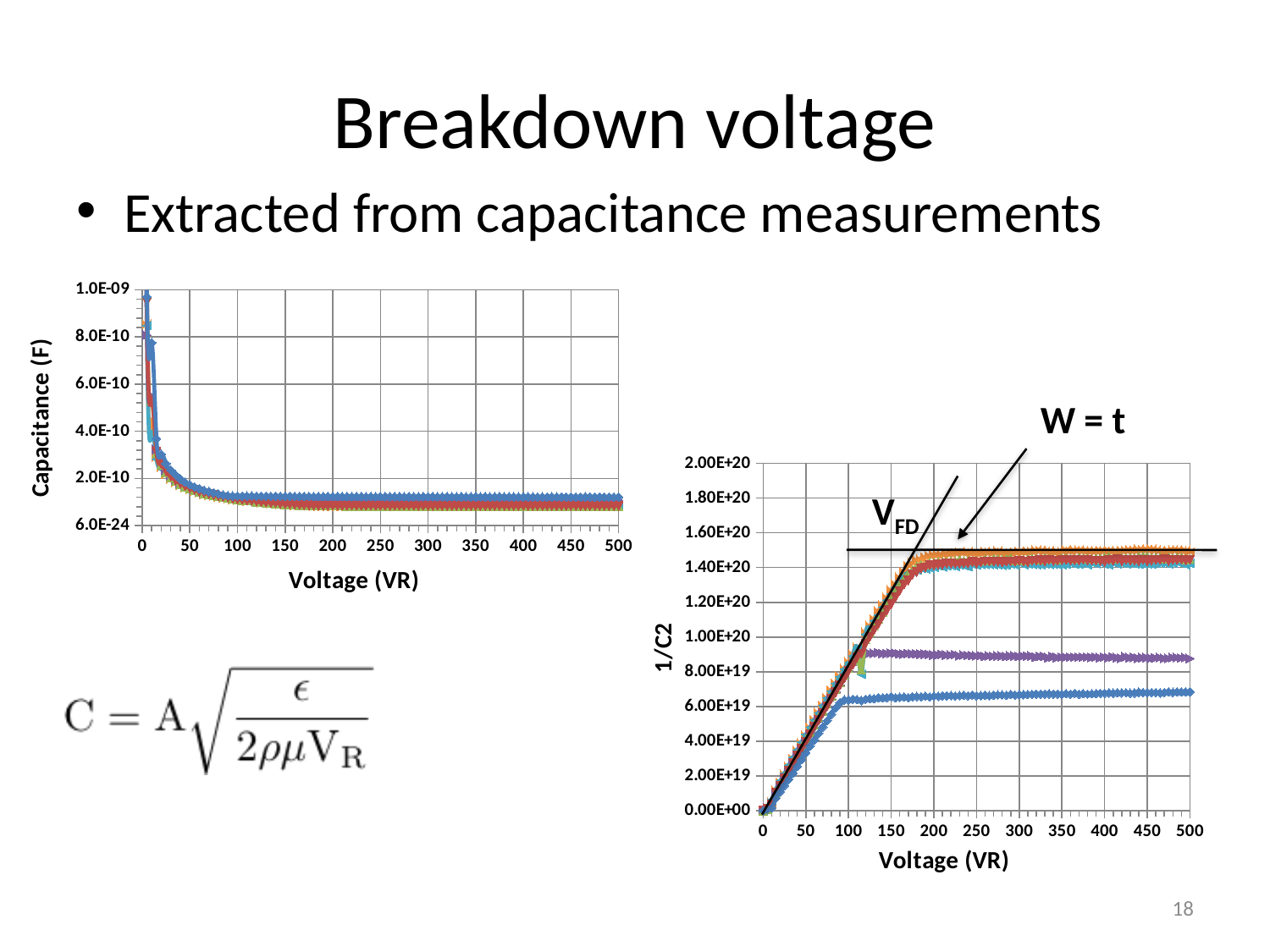
In the right chart, is the plateau value of the lowest series greater or less than 8.00E+19? less In the left chart, is the capacitance at 500 V greater or less than 2.0E-10? less In the right chart, is the plateau value of the highest group of series greater or less than 1.20E+20? greater In the right chart, do the 1/C2 values rise or fall as voltage increases from 0 to 100? rise What kind of chart is the left chart (Capacitance vs Voltage)? scatter chart What is the maximum value shown on the y axis of the right chart? 2.00E+20 What is the y-axis title of the left chart? Capacitance (F) In the right chart, which is larger at 500 V: the value of the lowest series or the value of the middle (purple) series? the middle (purple) series What kind of chart is the right chart (1/C2 vs Voltage)? scatter chart In the left chart, do the capacitance values rise or fall as voltage increases along the x axis? fall